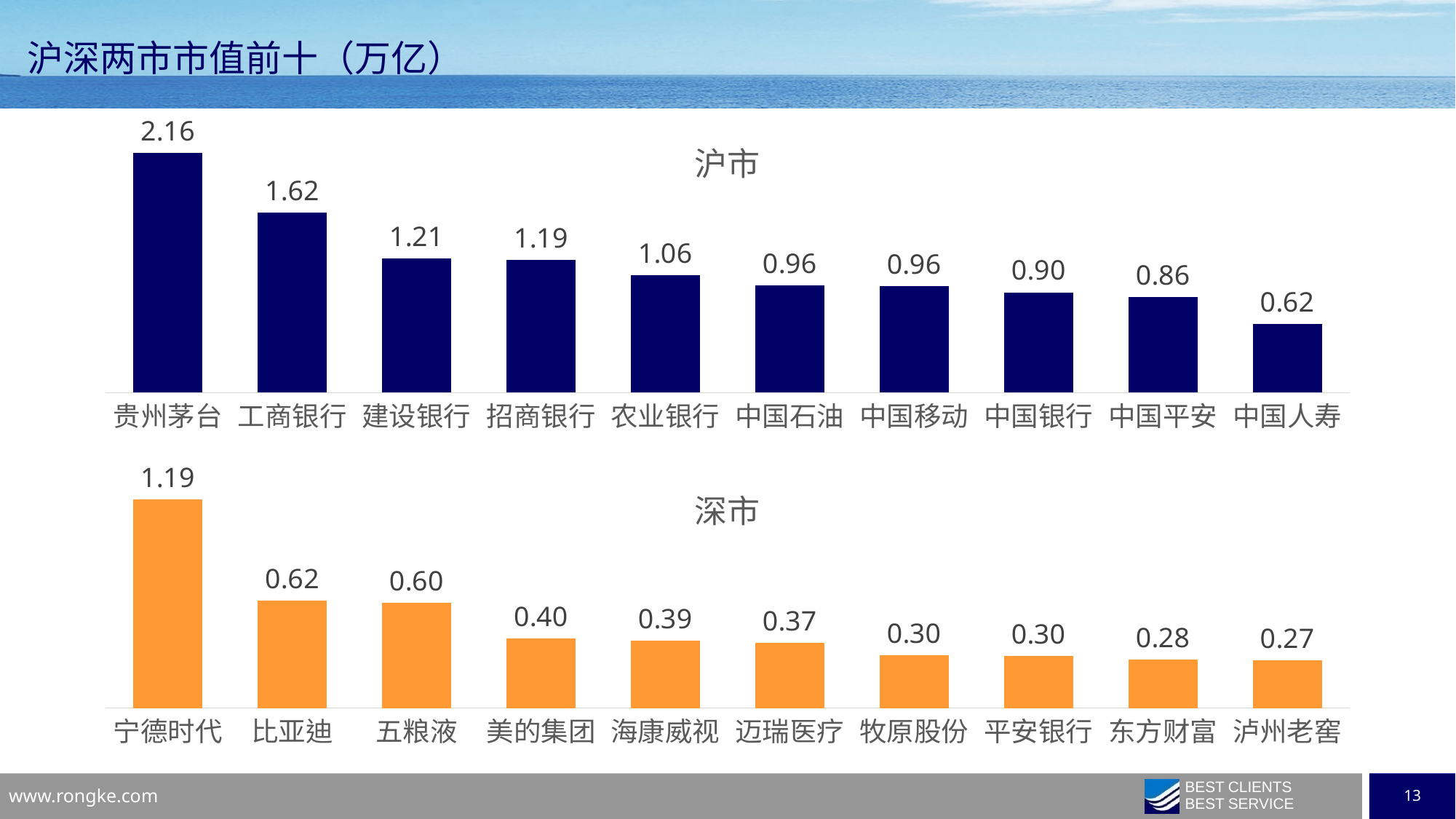
In the 深市 chart, what is the difference between 宁德时代 and 比亚迪? 0.57 In the 沪市 chart, what is the value for 农业银行? 1.06 In the 深市 chart, which category has the highest value? 宁德时代 In the 深市 chart, what is the value for 比亚迪? 0.62 What kind of chart is the 沪市 chart? bar chart In the 沪市 chart, what is the value for 贵州茅台? 2.16 In the 深市 chart, do the values rise or fall from left to right? fall In the 沪市 chart, which is larger, 建设银行 or 中国平安? 建设银行 How many categories are shown in the 深市 chart? 10 In the 深市 chart, what is the value for 迈瑞医疗? 0.37 In the 沪市 chart, which category has the lowest value? 中国人寿 In the 沪市 chart, what is the difference between 贵州茅台 and 工商银行? 0.54